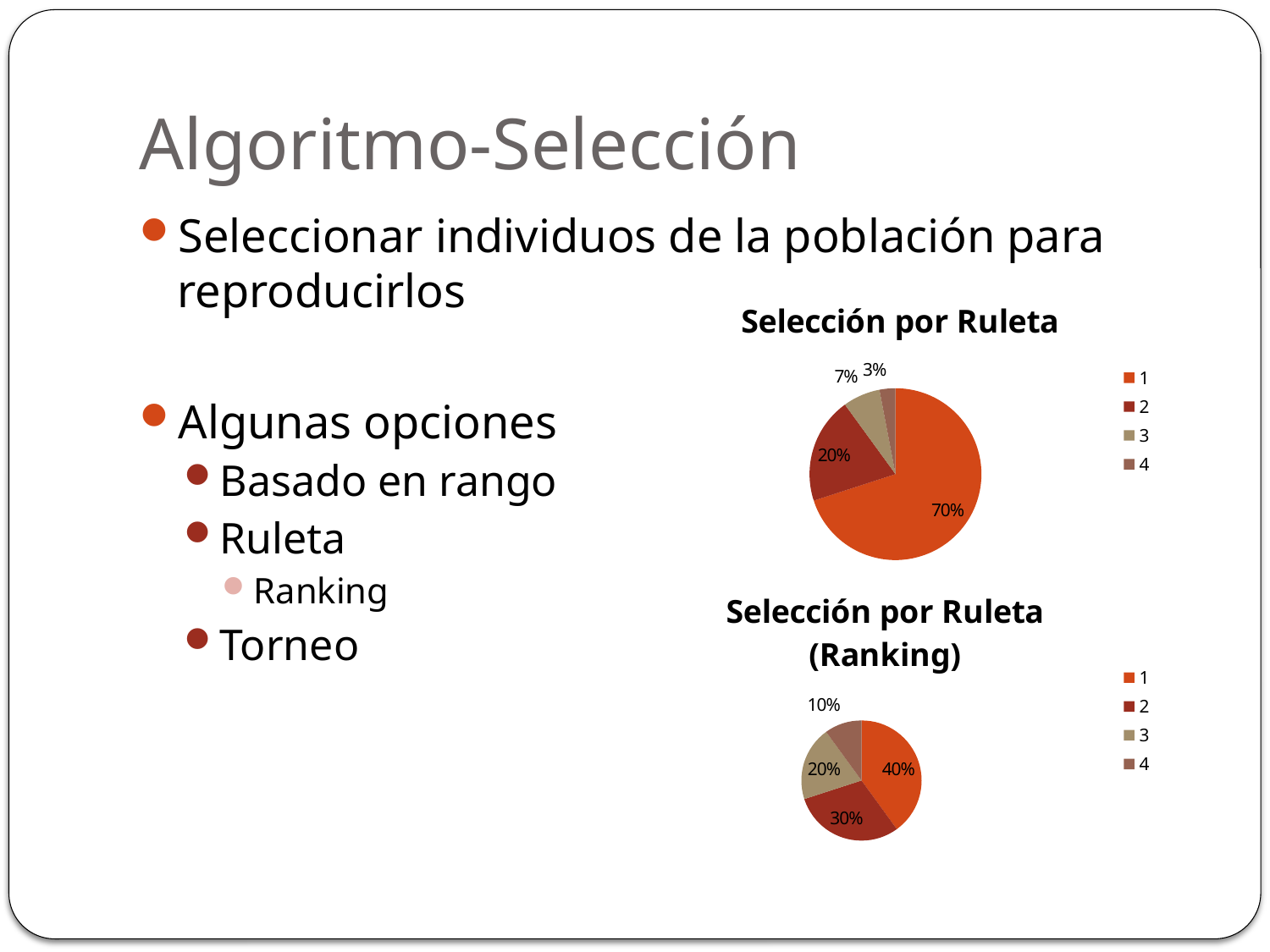
In the 'Selección por Ruleta (Ranking)' chart, what share does category 4 have? 10% In the 'Selección por Ruleta' chart, what share does category 4 have? 3% In the 'Selección por Ruleta' chart, which category has the largest slice? 1 In the 'Selección por Ruleta' chart, what share does category 1 have? 70% In the 'Selección por Ruleta' chart, what is the difference between the shares of category 2 and category 3? 13% In the 'Selección por Ruleta (Ranking)' chart, what share does category 2 have? 30% What type of chart is 'Selección por Ruleta (Ranking)'? Pie chart In the 'Selección por Ruleta' chart, which category has the smallest slice? 4 How many categories does the legend of the 'Selección por Ruleta' chart list? 4 In the 'Selección por Ruleta (Ranking)' chart, what is the difference between the shares of category 1 and category 2? 10% In the 'Selección por Ruleta (Ranking)' chart, which is larger, the share of category 3 or category 4? 3 In the 'Selección por Ruleta (Ranking)' chart, which category has the largest slice? 1